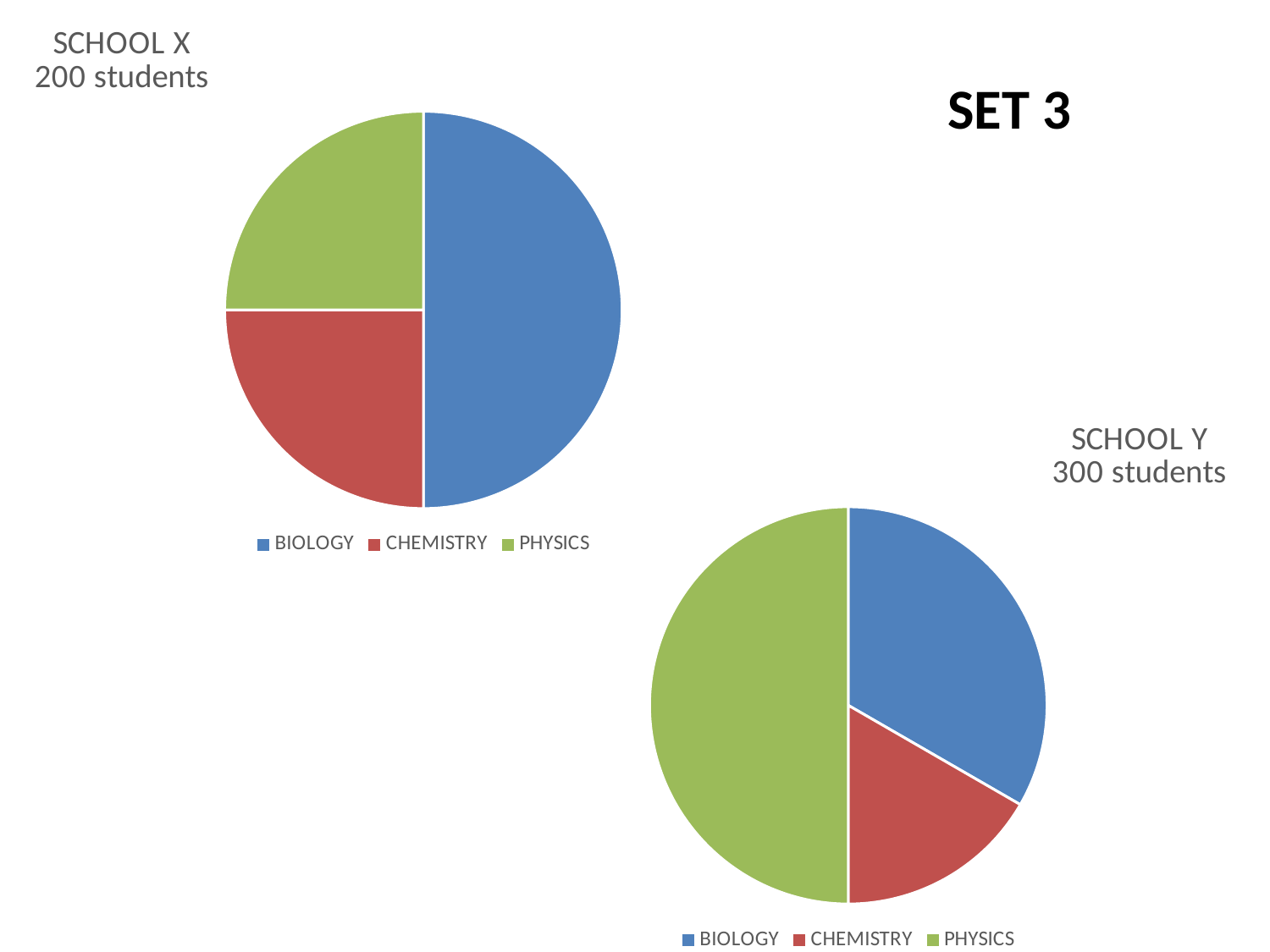
In the School Y chart, which slice is larger, BIOLOGY or CHEMISTRY? BIOLOGY In the School Y chart, which subject has the largest slice? PHYSICS In the School X chart, which slice is larger, BIOLOGY or CHEMISTRY? BIOLOGY What kind of chart is the School Y chart? pie chart How many entries does the legend of the School Y chart list? 3 In the School Y chart, which subject has the smallest slice? CHEMISTRY In the School X chart, which subject has the largest slice? BIOLOGY In the School X chart, which colour represents PHYSICS? green How many slices does the School X pie chart have? 3 In the School Y chart, which slice is larger, PHYSICS or BIOLOGY? PHYSICS How many students does the School Y chart represent, according to its title? 300 students What kind of chart is the School X chart? pie chart